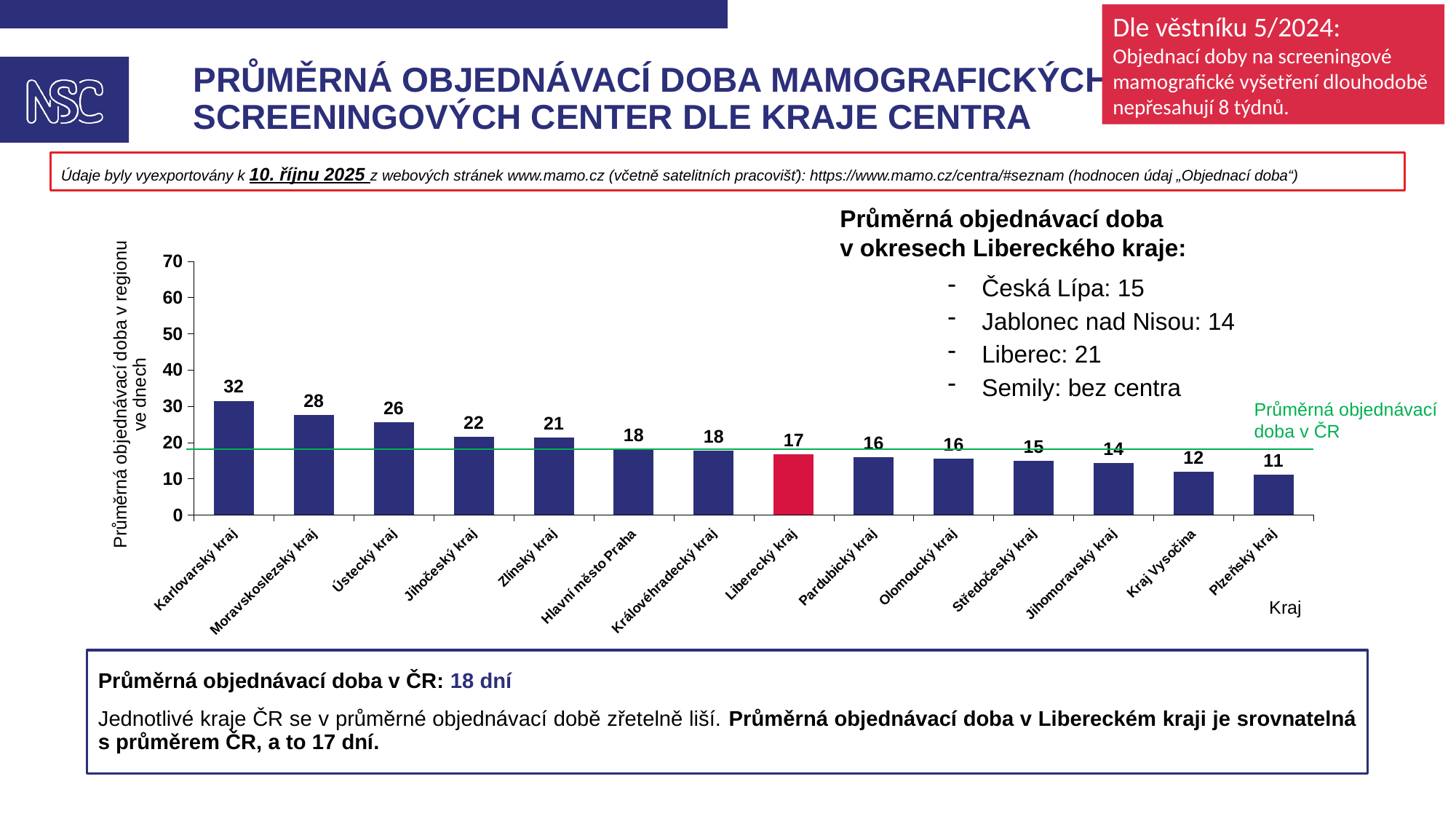
Is the value for Kraj Vysočina greater or less than 20? less What is the difference between the values for Ústecký kraj and Liberecký kraj? 9 What is the difference between the values for Karlovarský kraj and Moravskoslezský kraj? 4 What value is shown for Plzeňský kraj? 11 Which region has the highest average waiting time in the chart? Karlovarský kraj What is the average waiting time shown for Karlovarský kraj? 32 How many regions (bars) are shown in the chart? 14 Which has a higher value, Jihočeský kraj or Zlínský kraj? Jihočeský kraj Which region has the lowest average waiting time in the chart? Plzeňský kraj Which bar in the chart is highlighted in red? Liberecký kraj What value is shown for Liberecký kraj? 17 What type of chart is shown on the slide? bar chart